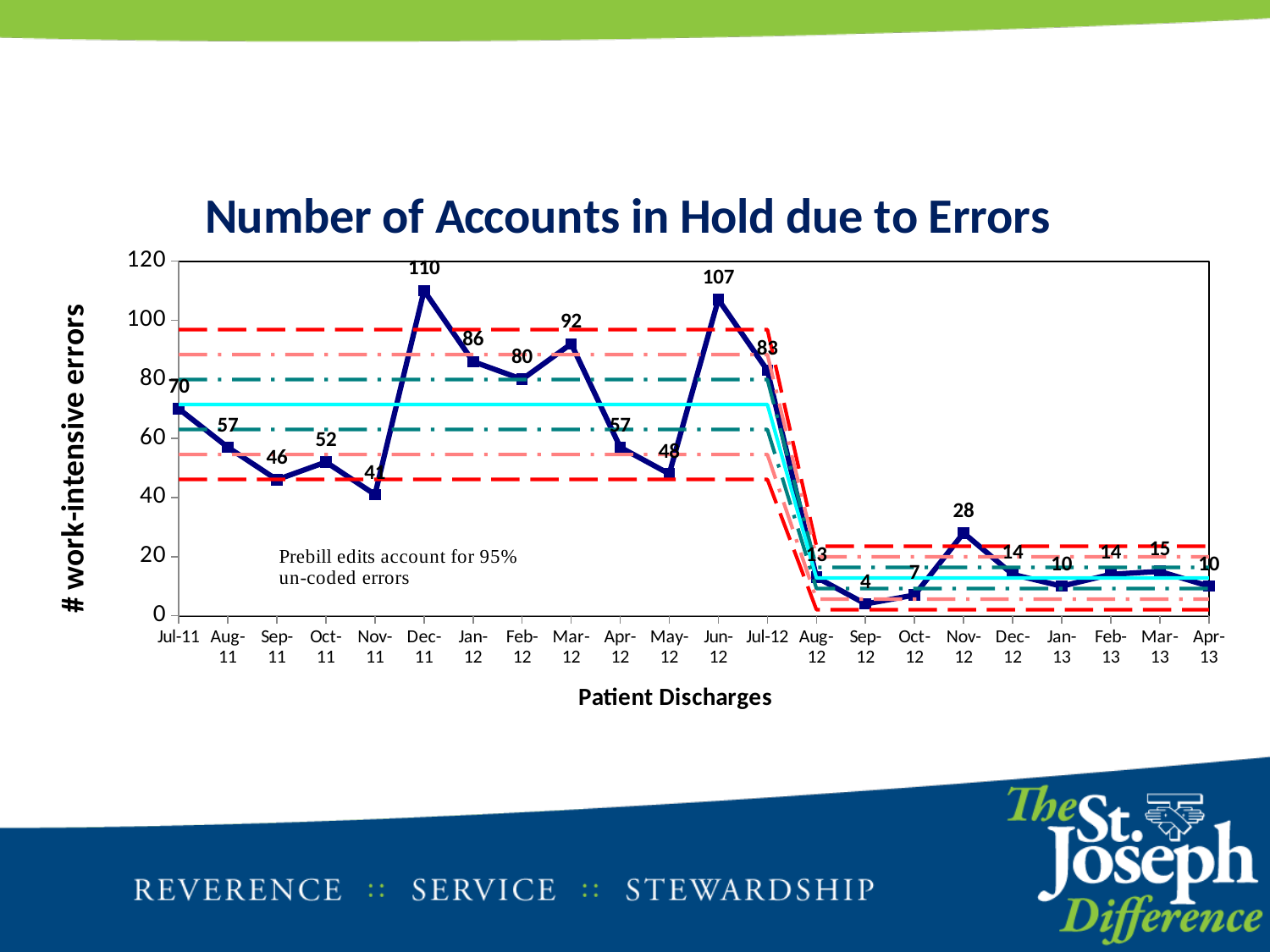
What kind of chart is shown on the slide? Line chart Is the value for Mar-12 greater or less than 80? greater What is the value for Jun-12? 107 What is the title of the chart? Number of Accounts in Hold due to Errors Which month has the highest number of work-intensive errors? Dec-11 Which is larger, the value for Nov-12 or the value for Dec-12? Nov-12 What is the difference between the values for Jul-12 and Aug-12? 70 Which month has the lowest number of work-intensive errors? Sep-12 What is the value for Sep-12? 4 What is the value for Dec-11? 110 How many data points are plotted on the chart? 22 What is the label of the y axis? # work-intensive errors